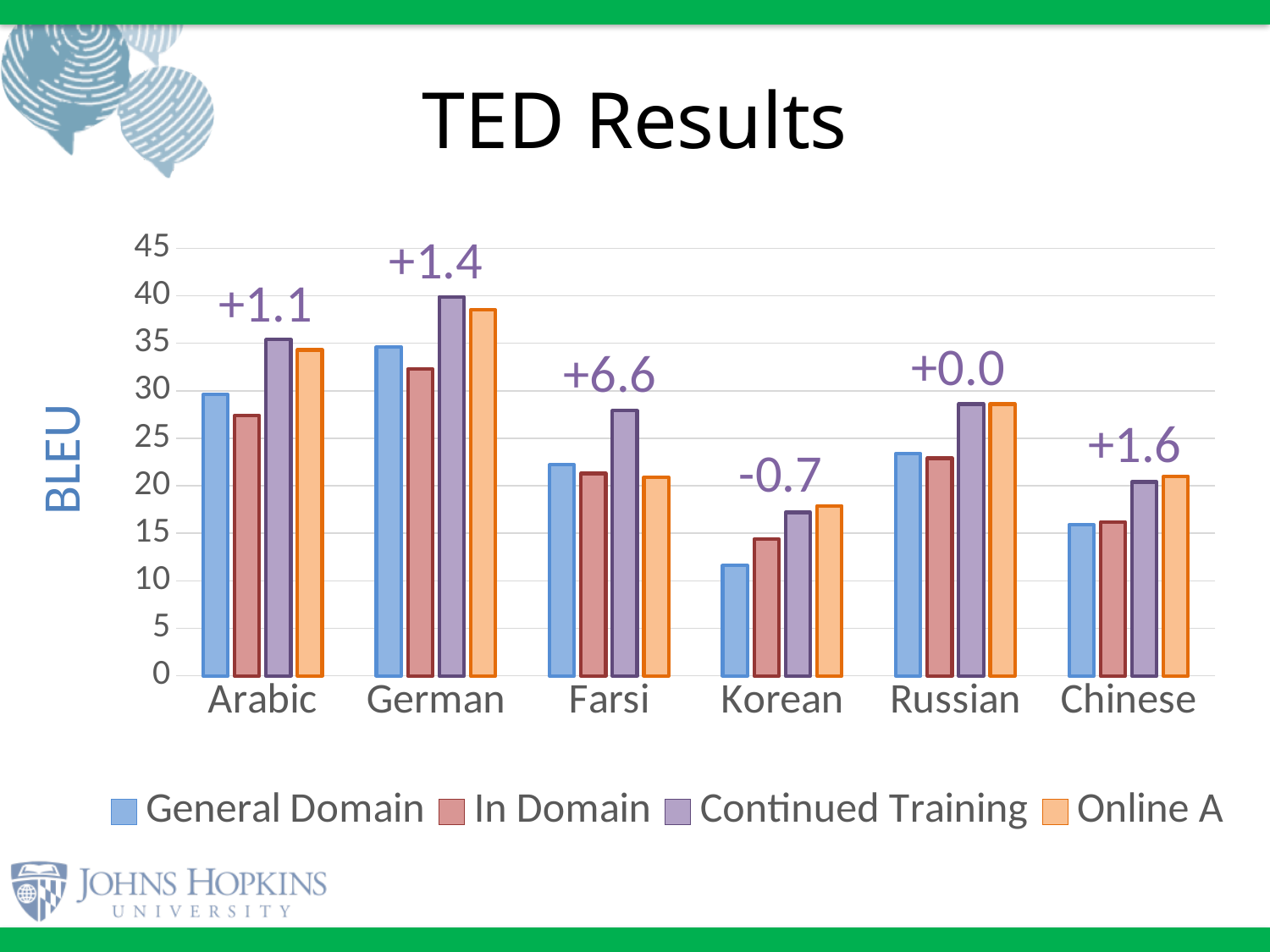
Which language has the highest Continued Training BLEU score? German What kind of chart is shown on the slide? bar chart Is the General Domain value for Korean greater or less than 15? less Which language has the lowest General Domain BLEU score? Korean How many languages are shown on the x axis of the chart? 6 For Farsi, which is larger: the Continued Training bar or the Online A bar? Continued Training What annotated value is printed above the Korean group of bars? -0.7 Is the Continued Training value for German greater or less than 35? greater What annotated value is printed above the Farsi group of bars? +6.6 How many series does the legend list? 4 Is the Online A value for Russian greater or less than 25? greater For Arabic, which is larger: the General Domain bar or the In Domain bar? General Domain